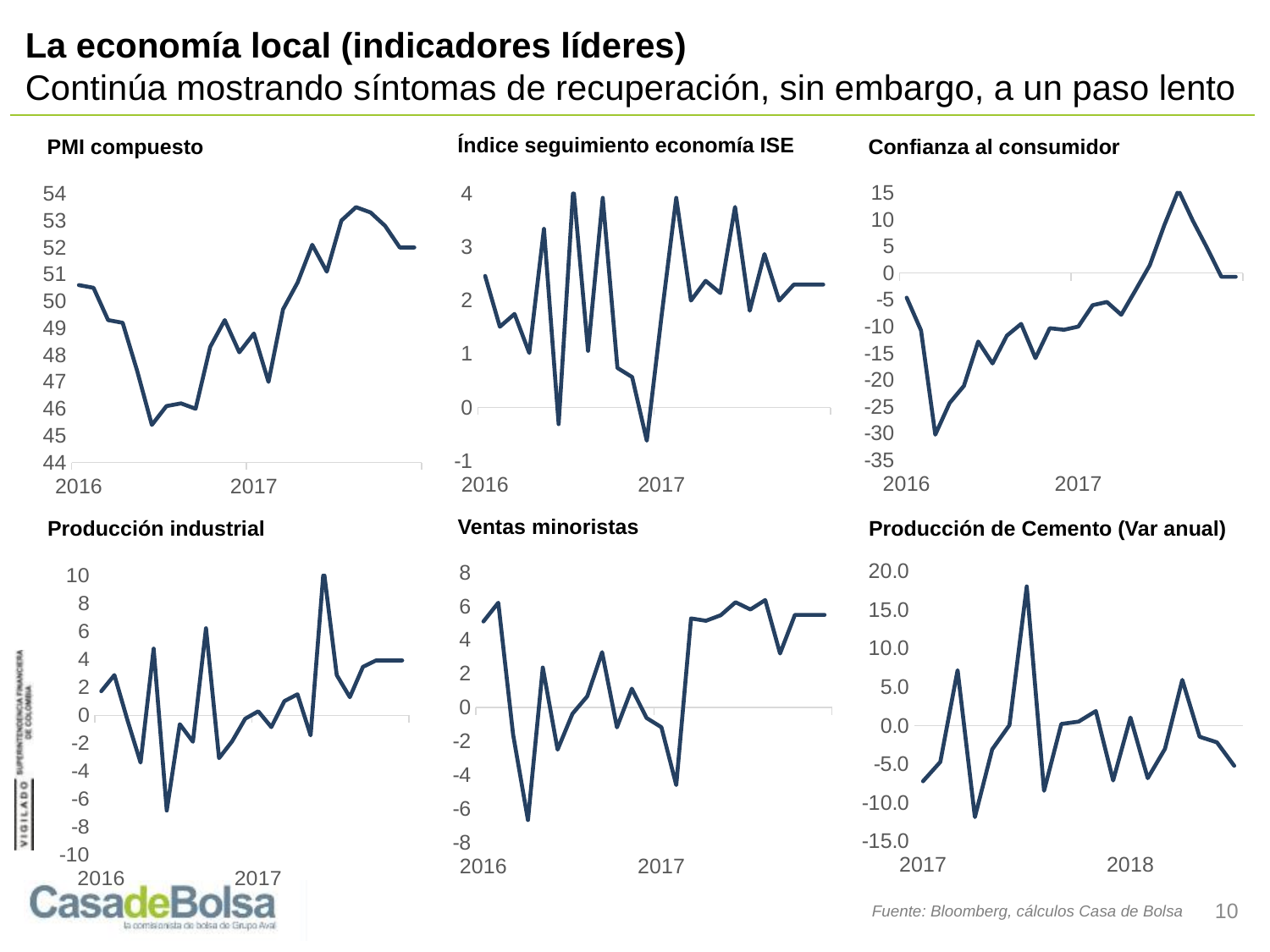
How many charts are shown on the slide? 6 In the 'Confianza al consumidor' chart, is the lowest value greater or less than -25? less In the 'PMI compuesto' chart, is the value at the end of the series higher or lower than at the start of 2016? higher In the 'Índice seguimiento economía ISE' chart, is the highest value of the series greater or less than 3? greater In the 'Producción de Cemento (Var anual)' chart, which year does the x axis start with? 2017 In the 'PMI compuesto' chart, is the lowest value of the series greater or less than 46? less Over the whole period shown, does the 'Confianza al consumidor' line generally rise or fall? rise What kind of chart is the 'PMI compuesto' chart? line chart